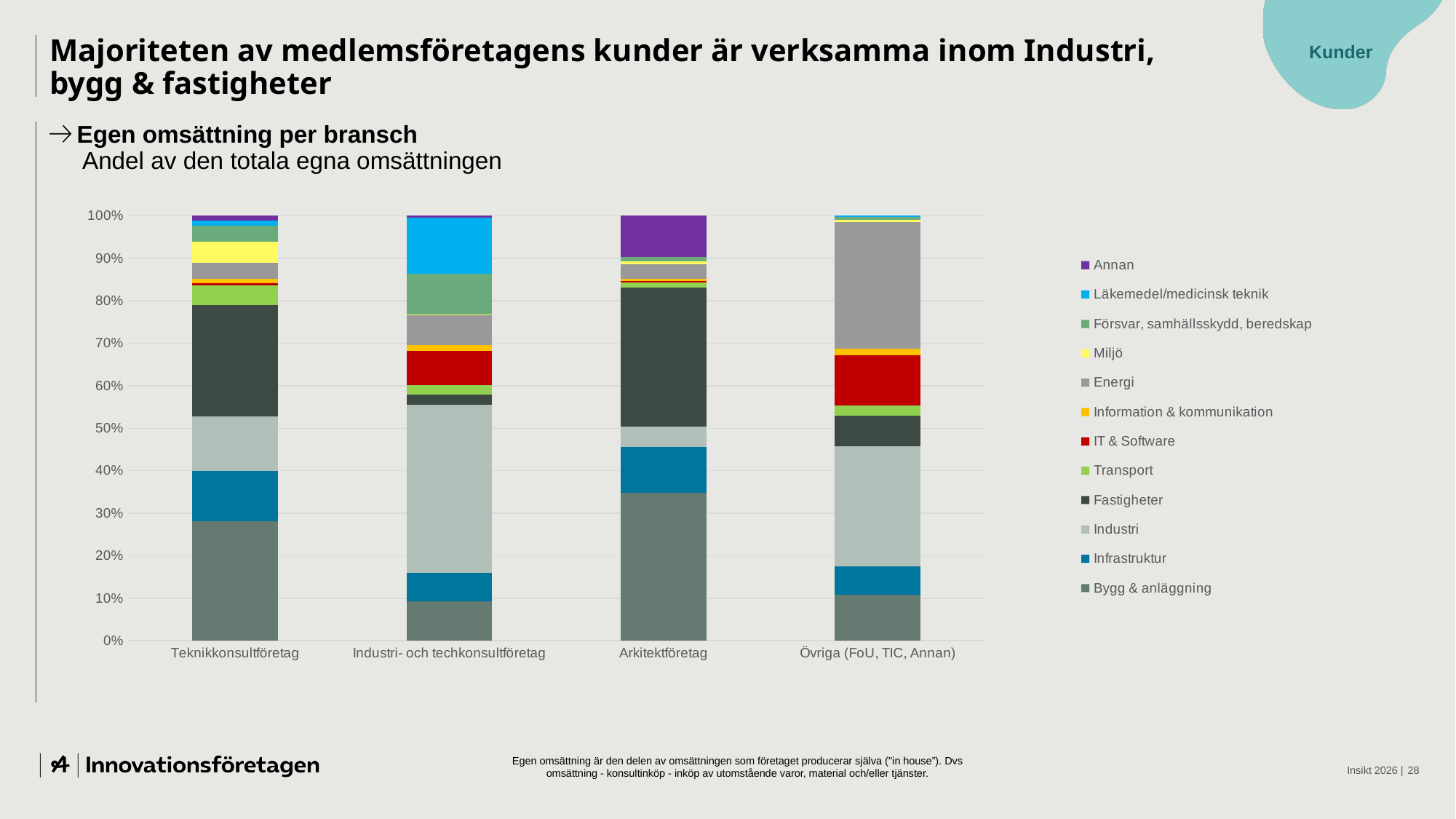
Which category has the largest Bygg & anläggning segment? Arkitektföretag How many series does the legend list? 12 What is the total of the stacked bar for Teknikkonsultföretag? 100% Is the Bygg & anläggning share for Teknikkonsultföretag greater or less than 30%? less Which series is shown at the bottom of each stacked bar? Bygg & anläggning Which category has the largest Industri segment? Industri- och techkonsultföretag What kind of chart is shown on the slide? Stacked bar chart Which category has the largest Energi segment? Övriga (FoU, TIC, Annan) Is the Bygg & anläggning share for Arkitektföretag greater or less than 30%? greater How many categories are shown on the x axis of the chart? 4